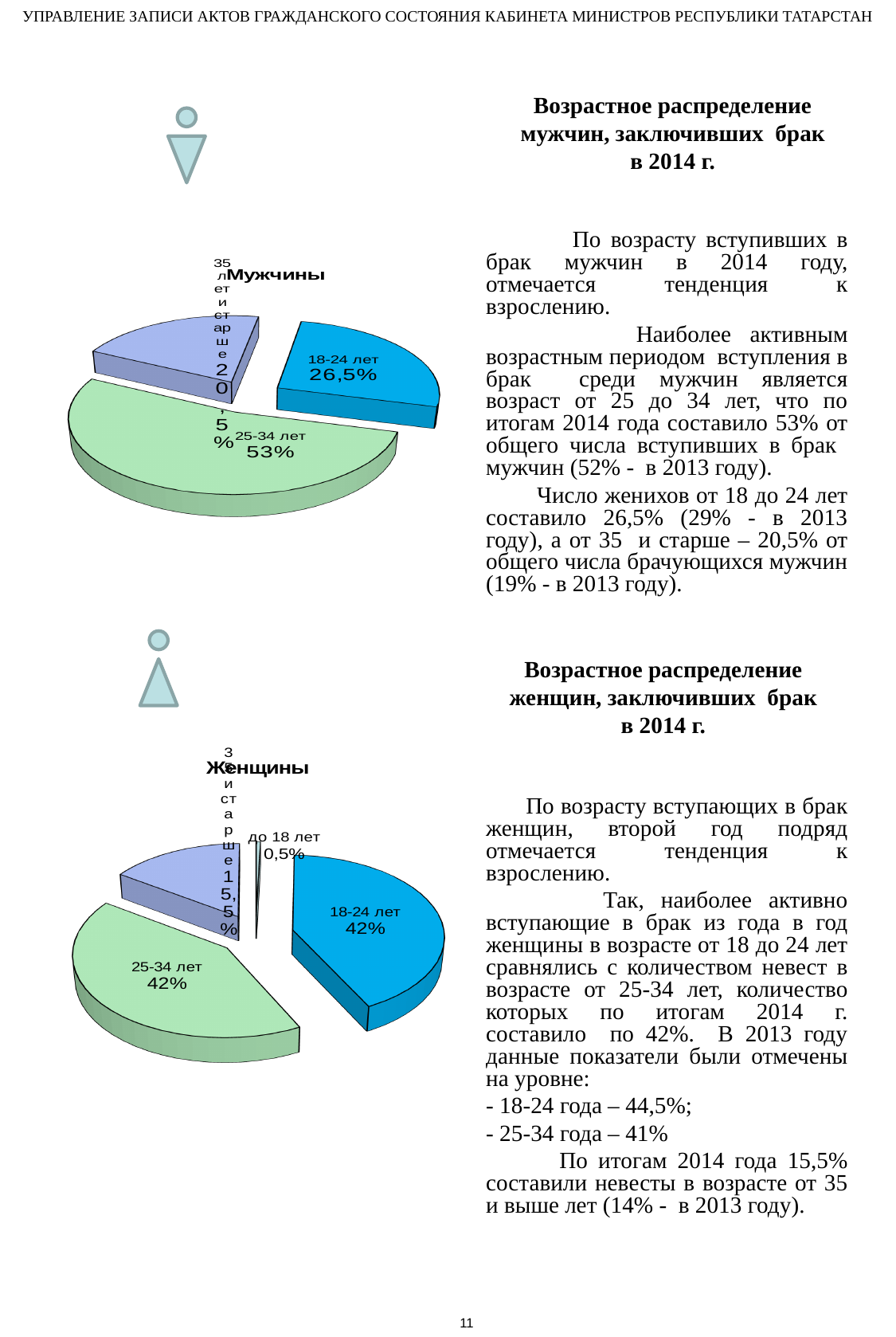
In the "Женщины" pie chart, what share of brides were aged 35 лет и старше? 15,5% In the "Мужчины" pie chart, what is the value for the 35 лет и старше slice? 20,5% In the "Женщины" pie chart, which age group has the smallest share? до 18 лет In the "Женщины" pie chart, what is the value for the до 18 лет slice? 0,5% How many slices does the "Женщины" pie chart have? 4 In the "Мужчины" pie chart, how many percentage points larger is the 25-34 лет slice than the 18-24 лет slice? 26,5 What type of chart is used for the "Женщины" data? Pie chart In the "Мужчины" pie chart, which age group has the largest share? 25-34 лет In the "Мужчины" pie chart, what share of men who married in 2014 were aged 25-34 лет? 53% How many slices does the "Мужчины" pie chart have? 3 In the "Мужчины" pie chart, what is the value for the 18-24 лет slice? 26,5% In the "Мужчины" pie chart, which age group has the smallest share? 35 лет и старше